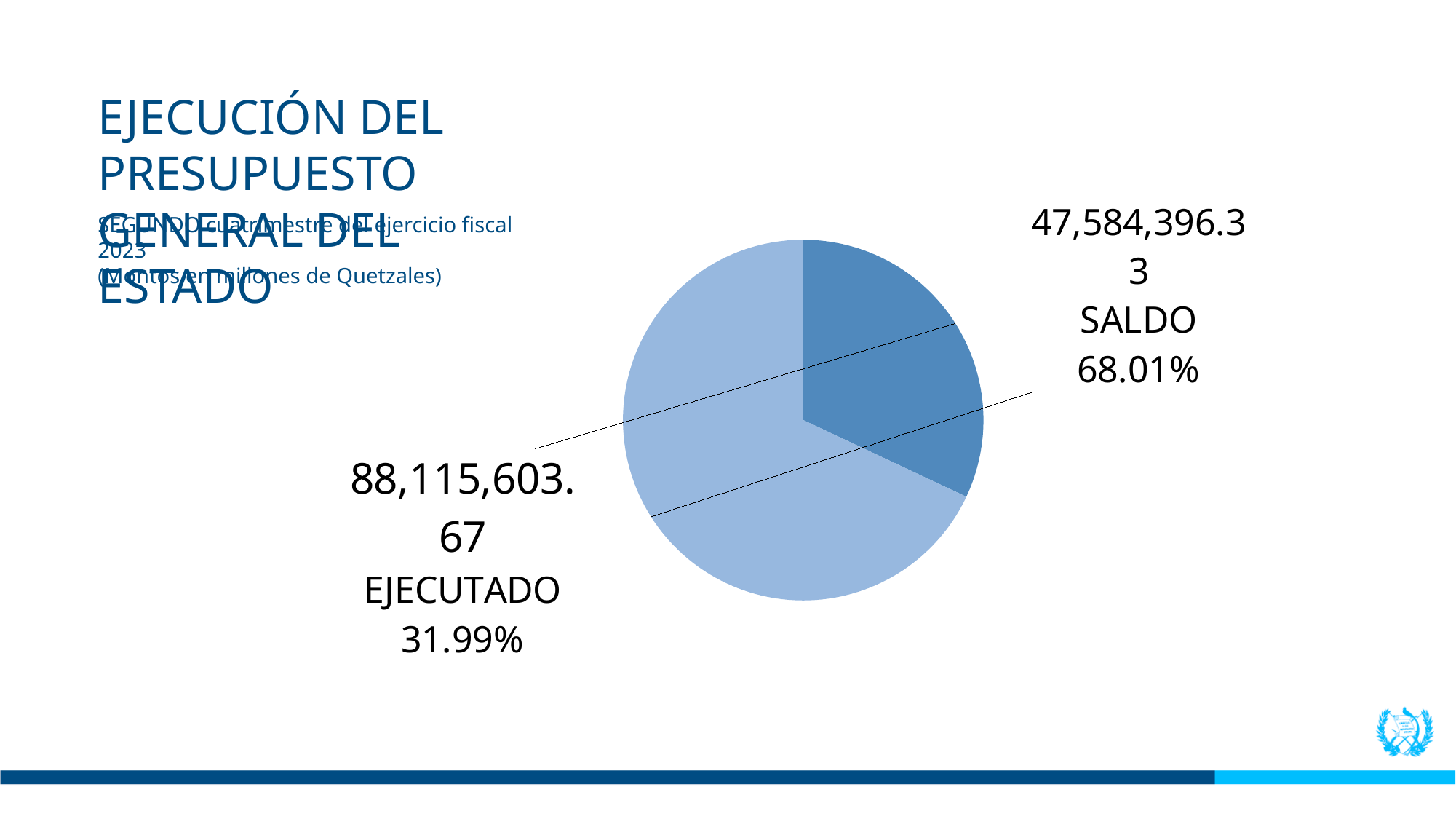
What percentage share is shown for the EJECUTADO slice? 31.99% Which slice is drawn in the darker blue, SALDO or EJECUTADO? EJECUTADO Which slice has the smallest percentage share on the pie chart? EJECUTADO What is the difference between the two percentage shares shown on the pie chart? 36.02% What kind of chart is shown on the slide? pie chart What is the sum of the two amounts labelled on the pie chart? 135,700,000.00 What amount is labelled for SALDO on the pie chart? 47,584,396.33 What amount is labelled for EJECUTADO on the pie chart? 88,115,603.67 What is the title of the slide containing the pie chart? EJECUCIÓN DEL PRESUPUESTO GENERAL DEL ESTADO How many slices does the pie chart have? 2 What percentage share is shown for the SALDO slice? 68.01% Which slice has the larger percentage share, SALDO or EJECUTADO? SALDO